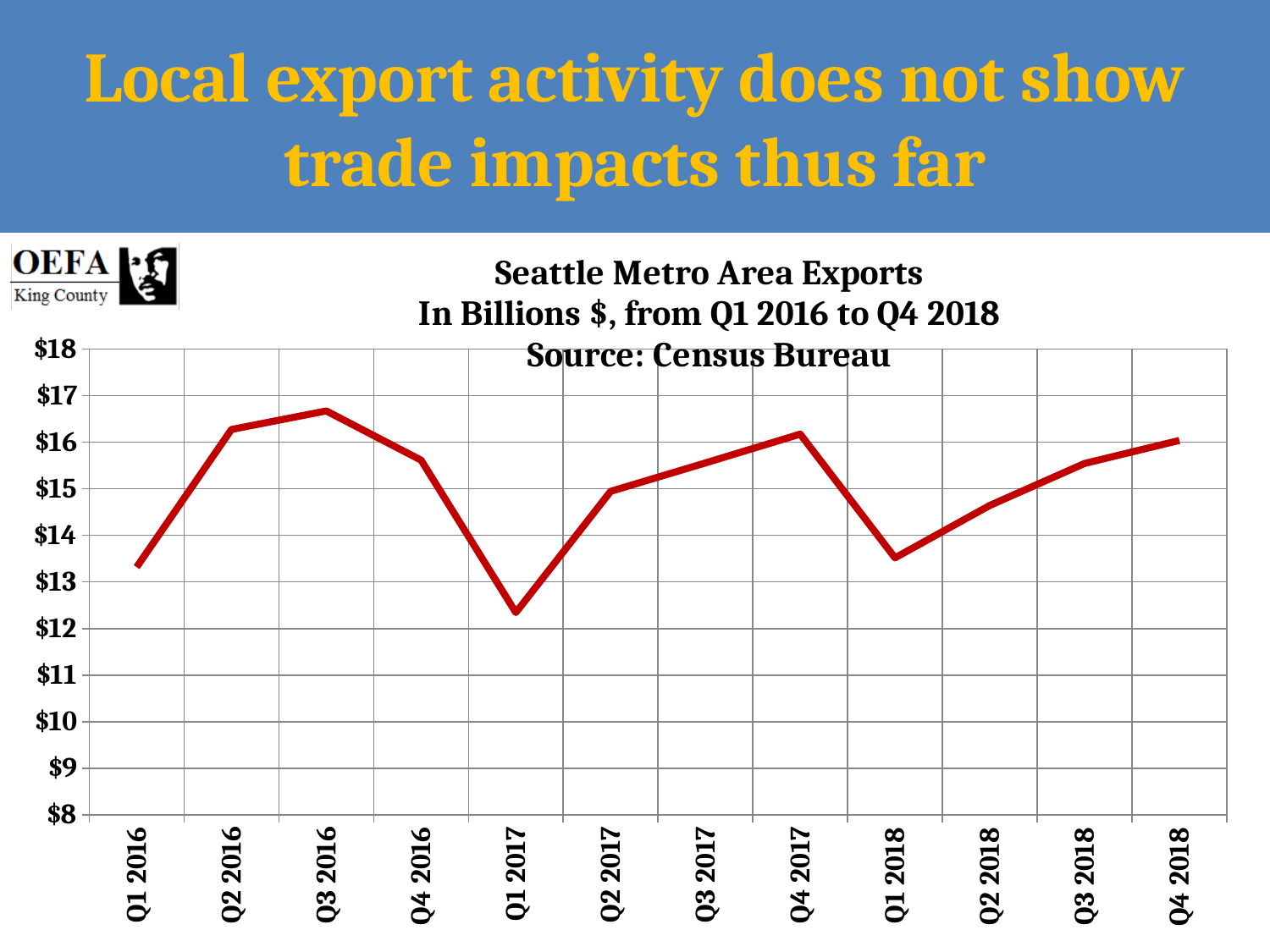
According to the chart subtitle, what is the source of the data? Census Bureau Which quarter has the highest export value? Q3 2016 Is the value for Q3 2016 greater or less than $16? greater Do exports rise or fall from Q1 2017 to Q4 2017? rise What kind of chart is shown on the slide? line chart How many quarters are plotted on the x axis? 12 Which is larger, the value for Q4 2017 or the value for Q1 2018? Q4 2017 Which quarter has the lowest export value? Q1 2017 Is the value for Q4 2018 greater or less than $15? greater Is the value for Q2 2018 greater or less than $15? less What is the title of the chart? Seattle Metro Area Exports